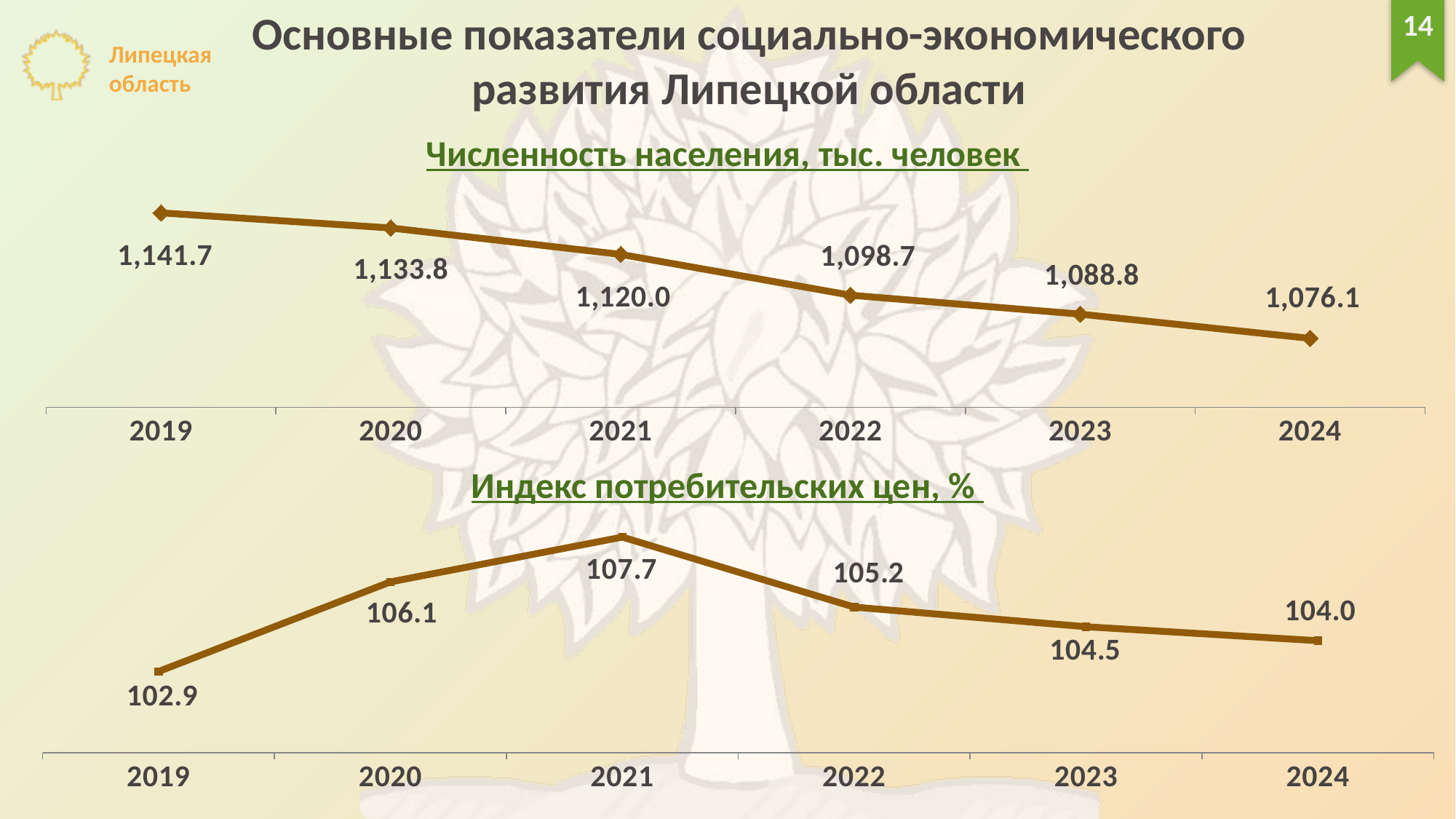
In the chart titled "Численность населения, тыс. человек", how many years are plotted? 6 In the chart titled "Индекс потребительских цен, %", which is larger, the value for 2020 or the value for 2023? 2020 In the chart titled "Индекс потребительских цен, %", which year has the lowest value? 2019 In the chart titled "Численность населения, тыс. человек", what is the value for 2024? 1,076.1 In the chart titled "Численность населения, тыс. человек", what is the difference between the 2019 and 2024 values? 65.6 In the chart titled "Индекс потребительских цен, %", which year has the highest value? 2021 In the chart titled "Численность населения, тыс. человек", what is the value for 2019? 1,141.7 In the chart titled "Численность населения, тыс. человек", which year has the lowest value? 2024 In the chart titled "Индекс потребительских цен, %", what is the value for 2021? 107.7 In the chart titled "Индекс потребительских цен, %", what is the difference between the 2021 and 2022 values? 2.5 What type of chart is the chart titled "Индекс потребительских цен, %"? line chart In the chart titled "Численность населения, тыс. человек", do the values rise or fall from 2019 to 2024? fall